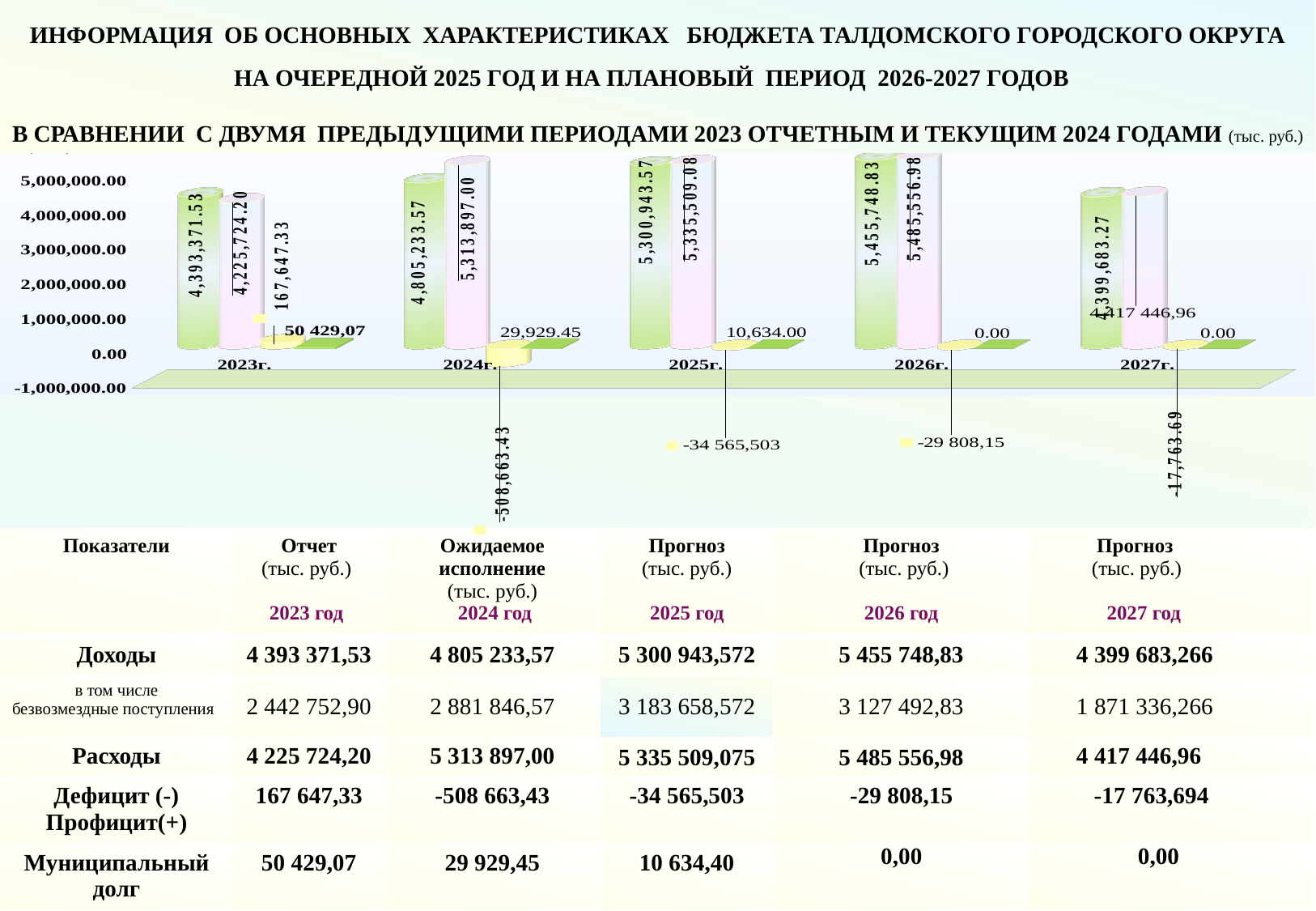
In which year is the green bar the tallest? 2026г. What value is printed below the axis for 2024г. (the deficit bar)? -508,663.43 What kind of chart is shown on the slide? bar chart What value is printed on the pink bar for 2025г.? 5,335,509.08 Is the value of the green bar for 2026г. greater or less than 5,000,000.00? greater How many year categories are shown along the x axis of the chart? 5 What is the difference between the green bar (4,393,371.53) and the pink bar (4,225,724.20) for 2023г.? 167,647.33 Do the green bars rise or fall from 2023г. to 2026г.? rise For 2023г., which is larger: the green bar or the pink bar? the green bar In which year is the green bar the shortest? 2023г. What value is printed on the green bar for 2024г.? 4,805,233.57 What value is printed on the green bar for 2027г.? 4,399,683.27